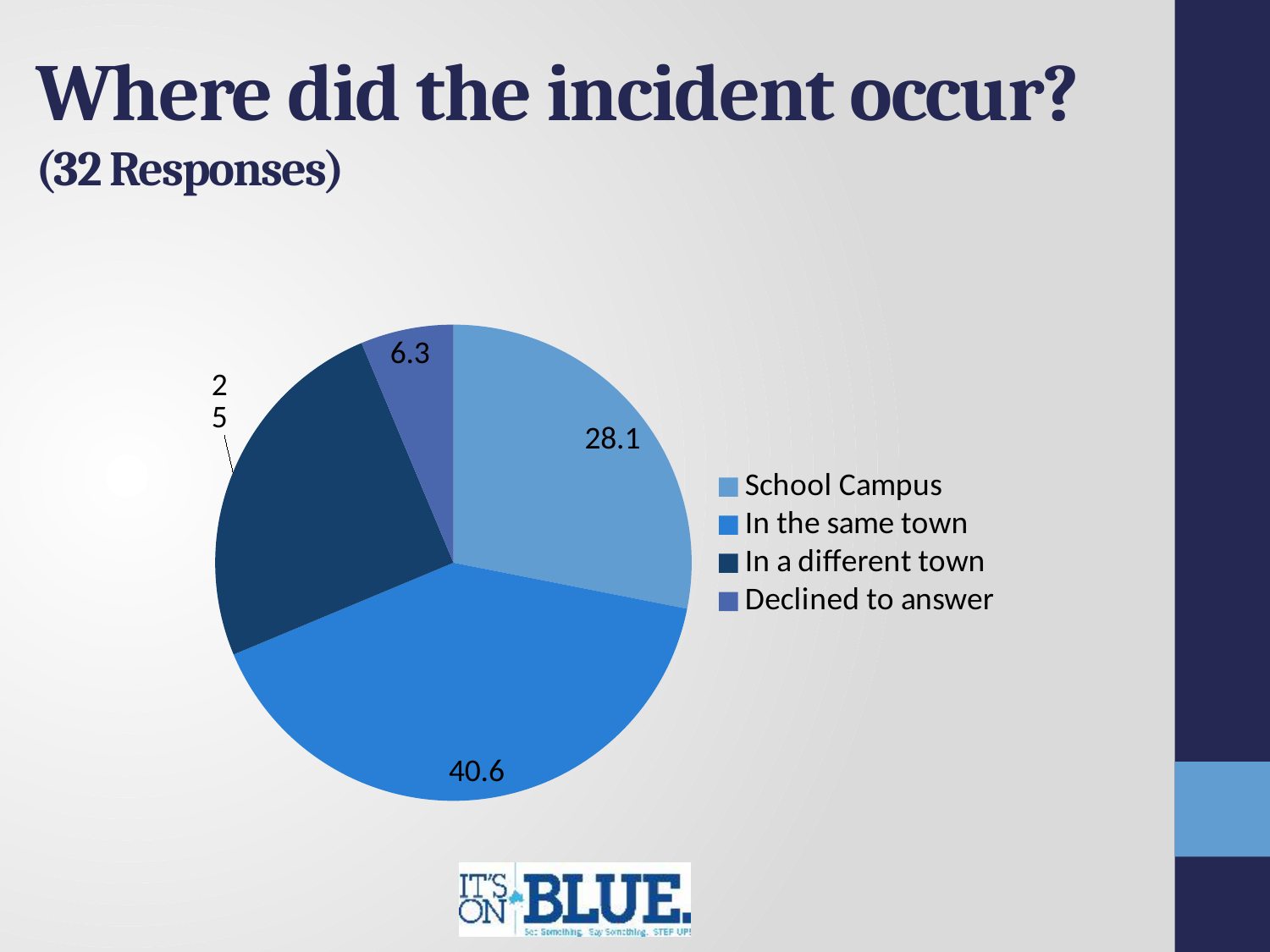
What is the difference between the values for "In the same town" and "School Campus"? 12.5 What is the title of the slide containing the chart? Where did the incident occur? How many responses does the slide say the chart is based on? 32 Which category has the largest slice of the pie? In the same town Which category has the smallest slice of the pie? Declined to answer What is the value for "In the same town"? 40.6 What is the value for "School Campus"? 28.1 How many categories does the pie chart have? 4 What type of chart is shown on the slide? Pie chart What is the value for "In a different town"? 25 Which is larger, the value for "School Campus" or the value for "In a different town"? School Campus What is the value for "Declined to answer"? 6.3